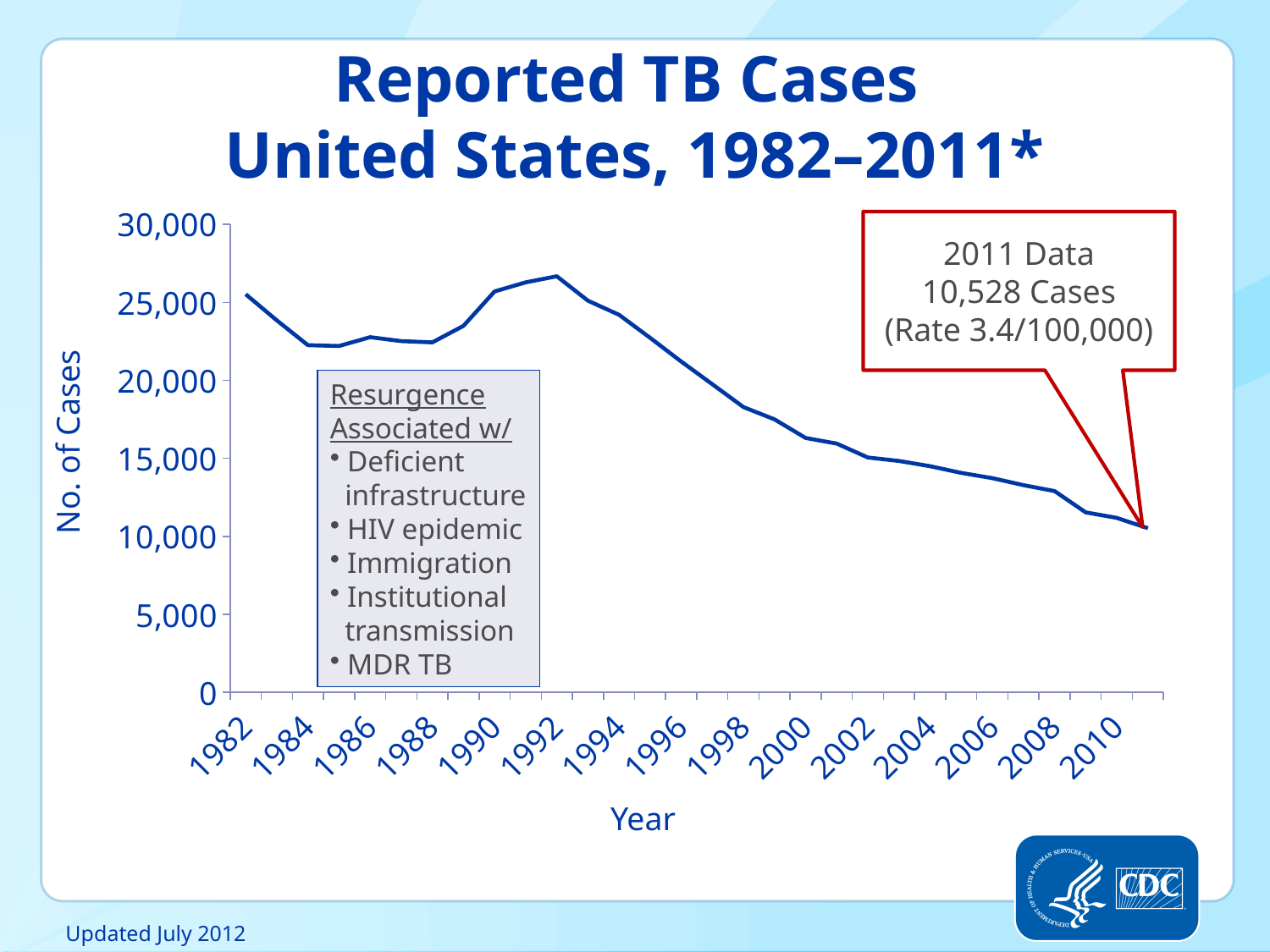
Is the number of cases in 2000 greater or less than 20,000? less In which year is the number of reported TB cases lowest? 2011 Do reported TB cases rise or fall from 1988 to 1992? rise Is the number of cases in 1992 greater or less than 25,000? greater What kind of chart is shown on the slide? line chart Which year had more reported TB cases, 1982 or 2010? 1982 How many reported TB cases are shown for 2011? 10,528 What is the label on the vertical axis? No. of Cases In which year does the number of reported TB cases peak? 1992 Do reported TB cases rise or fall from 1992 to 2011? fall Is the number of cases in 2010 greater or less than 15,000? less What rate per 100,000 is given for the 2011 data? 3.4/100,000